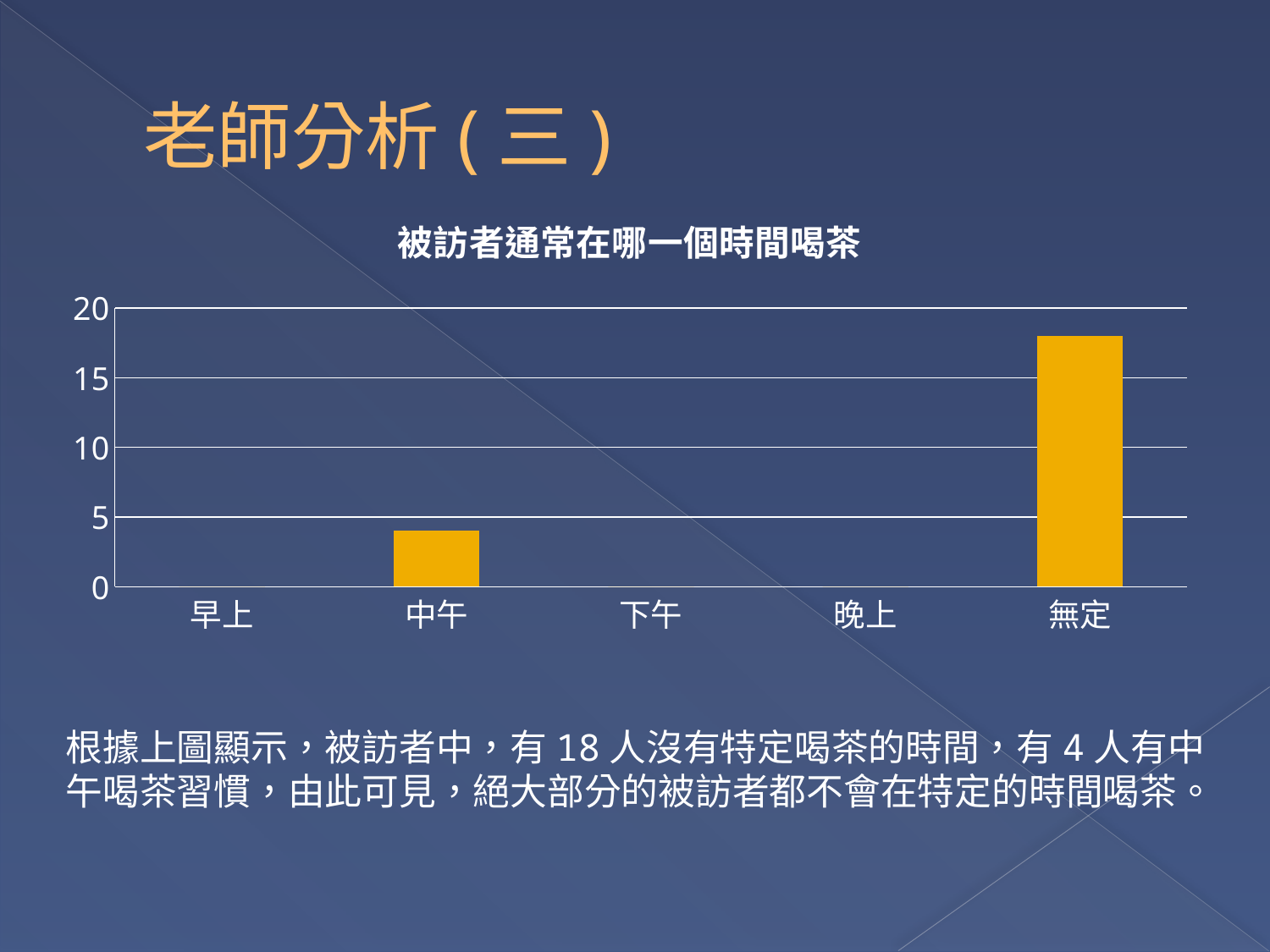
What is the title of the chart? 被訪者通常在哪一個時間喝茶 What colour are the bars in the chart? orange What is the difference between the values for 無定 and 中午? 14 How many categories are shown on the x axis of the chart? 5 Which category has the highest value in the chart? 無定 What type of chart is shown on the slide? bar chart Is the value for 中午 greater or less than 5? less What is the value for 無定? 18 Which is larger, the value for 中午 or the value for 無定? 無定 Is the value for 無定 greater or less than 15? greater What is the value for 早上? 0 What is the value for 中午? 4